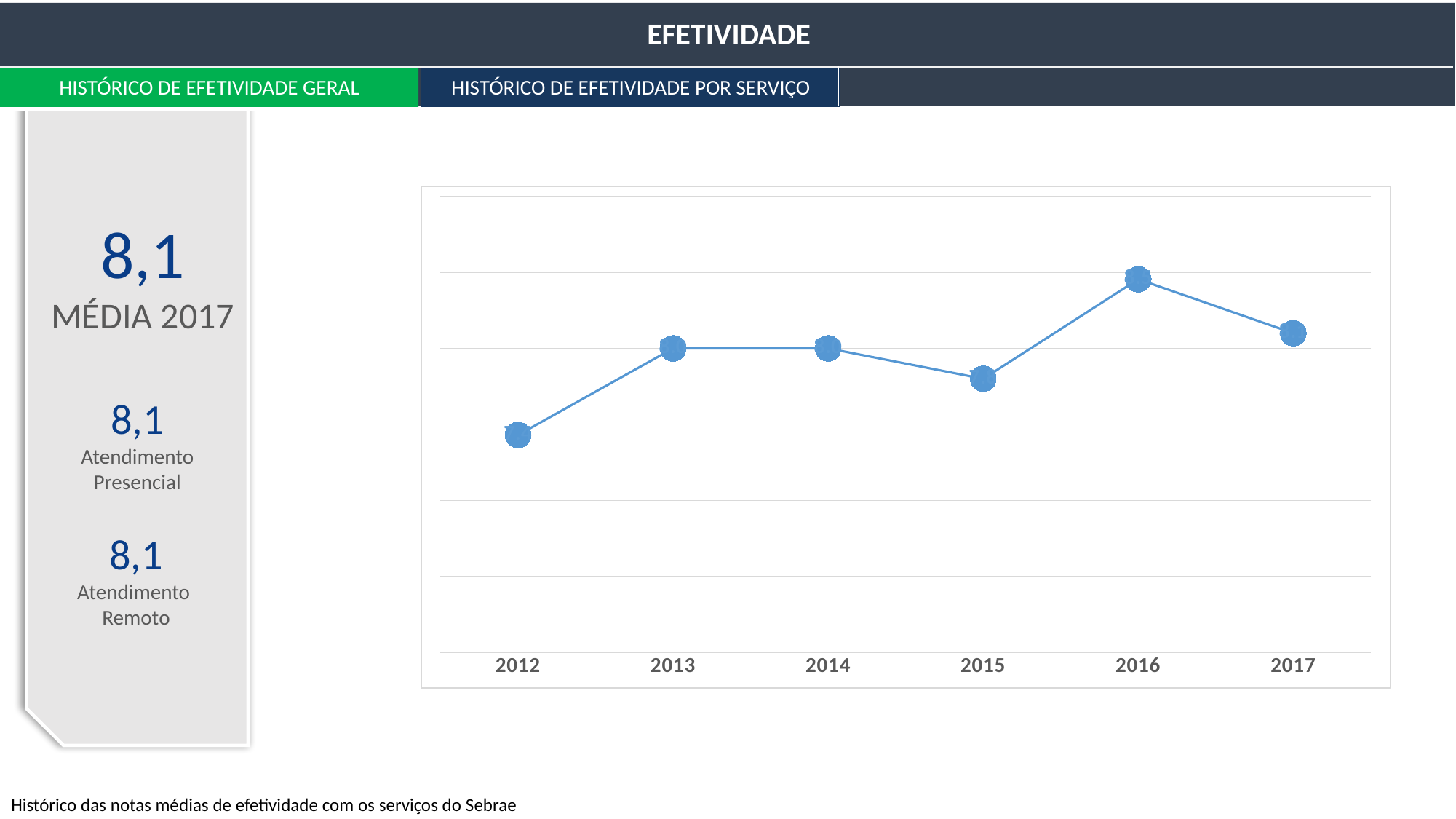
Which is higher on the line chart, 2012 or 2015? 2015 Which year has the lowest point on the line chart? 2012 Does the line rise or fall from 2016 to 2017? fall What is the first year shown on the x axis of the line chart? 2012 What is the last year shown on the x axis of the line chart? 2017 Which year has the highest point on the line chart? 2016 Does the line rise or fall from 2012 to 2013? rise What kind of chart is shown on the slide? line chart How many years are plotted on the x axis of the line chart? 6 Does the line rise or fall from 2014 to 2015? fall Which is higher on the line chart, 2016 or 2017? 2016 Which is higher on the line chart, 2013 or 2015? 2013